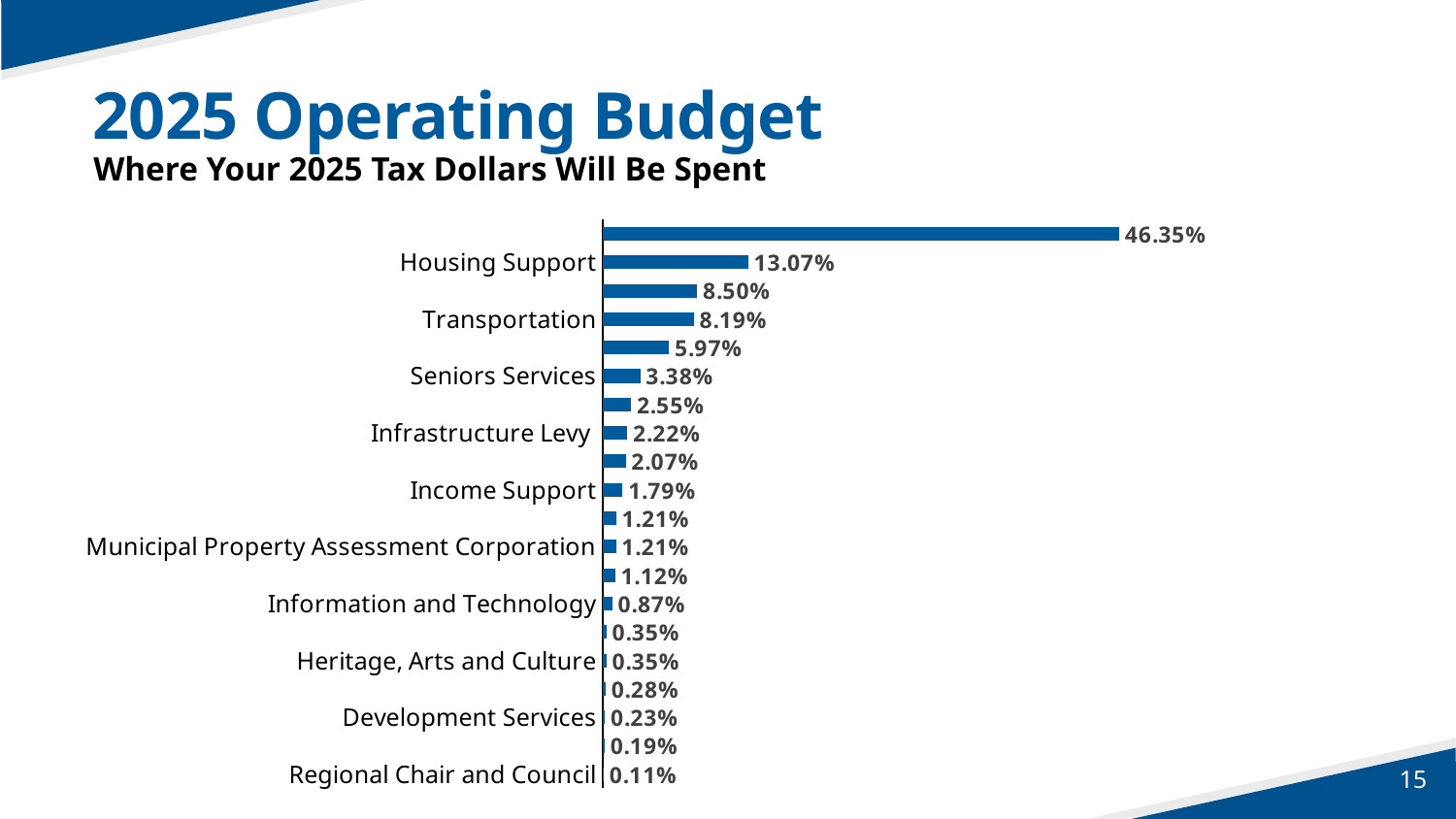
What is the value for Income Support? 1.79% What is the largest value shown on the chart? 46.35% What is the value shown for Transportation? 8.19% How many bars are plotted on the chart? 20 What share is shown for Seniors Services? 3.38% What is the value for Development Services? 0.23% Which is larger, the value for Infrastructure Levy or the value for Income Support? Infrastructure Levy What kind of chart is shown on the slide? Bar chart What percentage of 2025 tax dollars goes to Housing Support? 13.07% What is the value for Municipal Property Assessment Corporation? 1.21% What is the difference between the values for Housing Support and Transportation? 4.88 percentage points Which labelled category has the lowest value? Regional Chair and Council